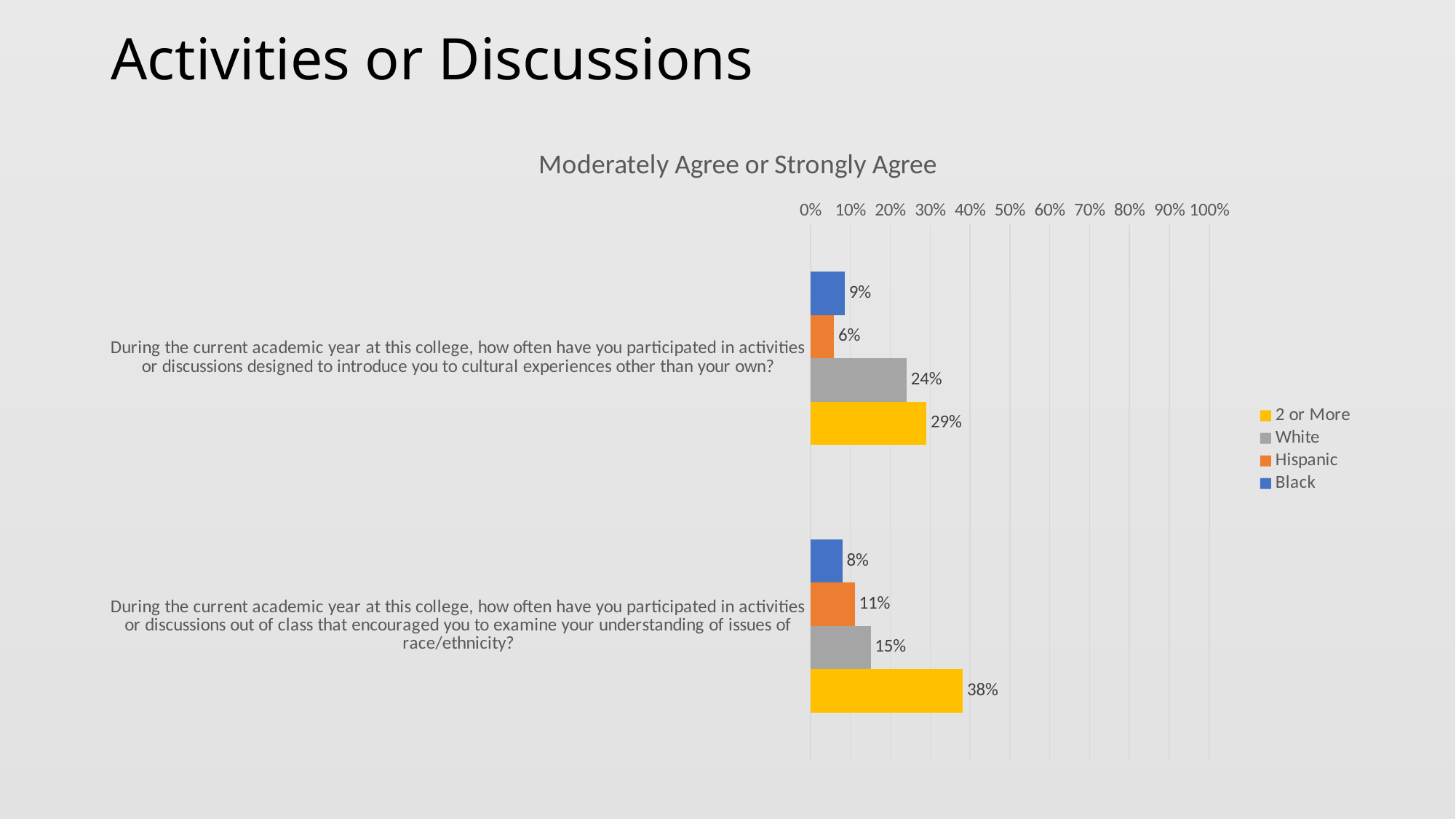
What is the title of the chart? Moderately Agree or Strongly Agree How many series does the legend list? 4 What kind of chart is shown on the slide? Bar chart What is the difference between the 2 or More value and the White value on the question about examining your understanding of issues of race/ethnicity? 23% What is the value for the 2 or More series on the question about examining your understanding of issues of race/ethnicity? 38% What is the value for the White series on the question about cultural experiences other than your own? 24% What is the value for the Black series on the question about cultural experiences other than your own? 9% What is the value for the Hispanic series on the question about examining your understanding of issues of race/ethnicity? 11% Which series has the highest value on the question about cultural experiences other than your own? 2 or More Is the value for 2 or More on the question about examining your understanding of issues of race/ethnicity greater or less than 30%? greater Which series has the lowest value on the question about examining your understanding of issues of race/ethnicity? Black Which is larger on the question about cultural experiences other than your own: the Hispanic value or the Black value? Black